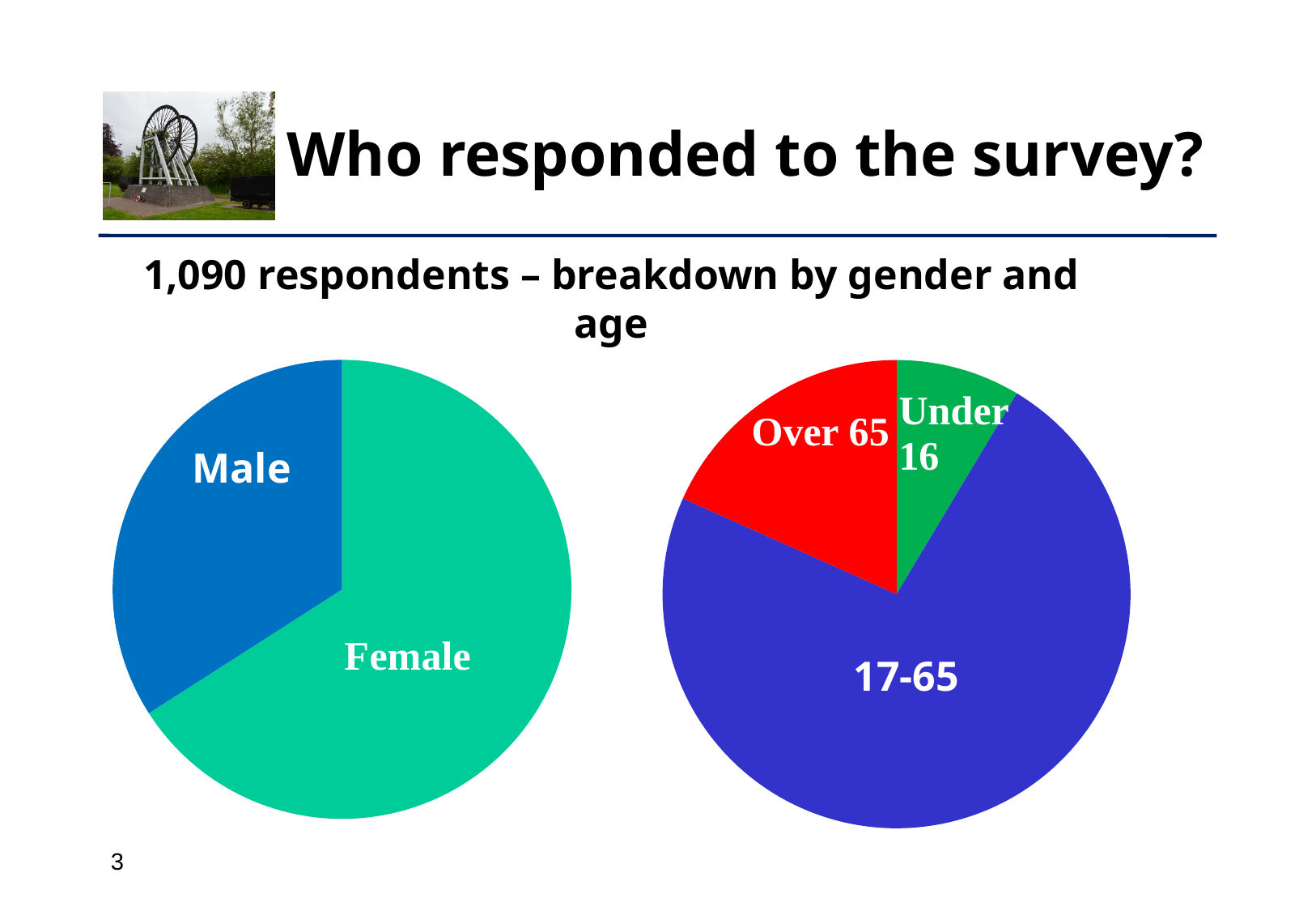
What kind of chart is the right chart on the slide? Pie chart How many respondents does the slide say took part in the survey? 1,090 In the left pie chart (gender), which slice is the largest? Female In the right pie chart (age), what colour is the Over 65 slice? Red In the right pie chart (age), how many slices are there? 3 In the left pie chart (gender), which slice is the smallest? Male What kind of chart is the left chart on the slide? Pie chart In the left pie chart (gender), which slice is larger, Male or Female? Female In the right pie chart (age), which age group has the largest slice? 17-65 In the right pie chart (age), which age group has the smallest slice? Under 16 In the left pie chart (gender), how many slices are there? 2 In the right pie chart (age), which slice is larger, Over 65 or Under 16? Over 65